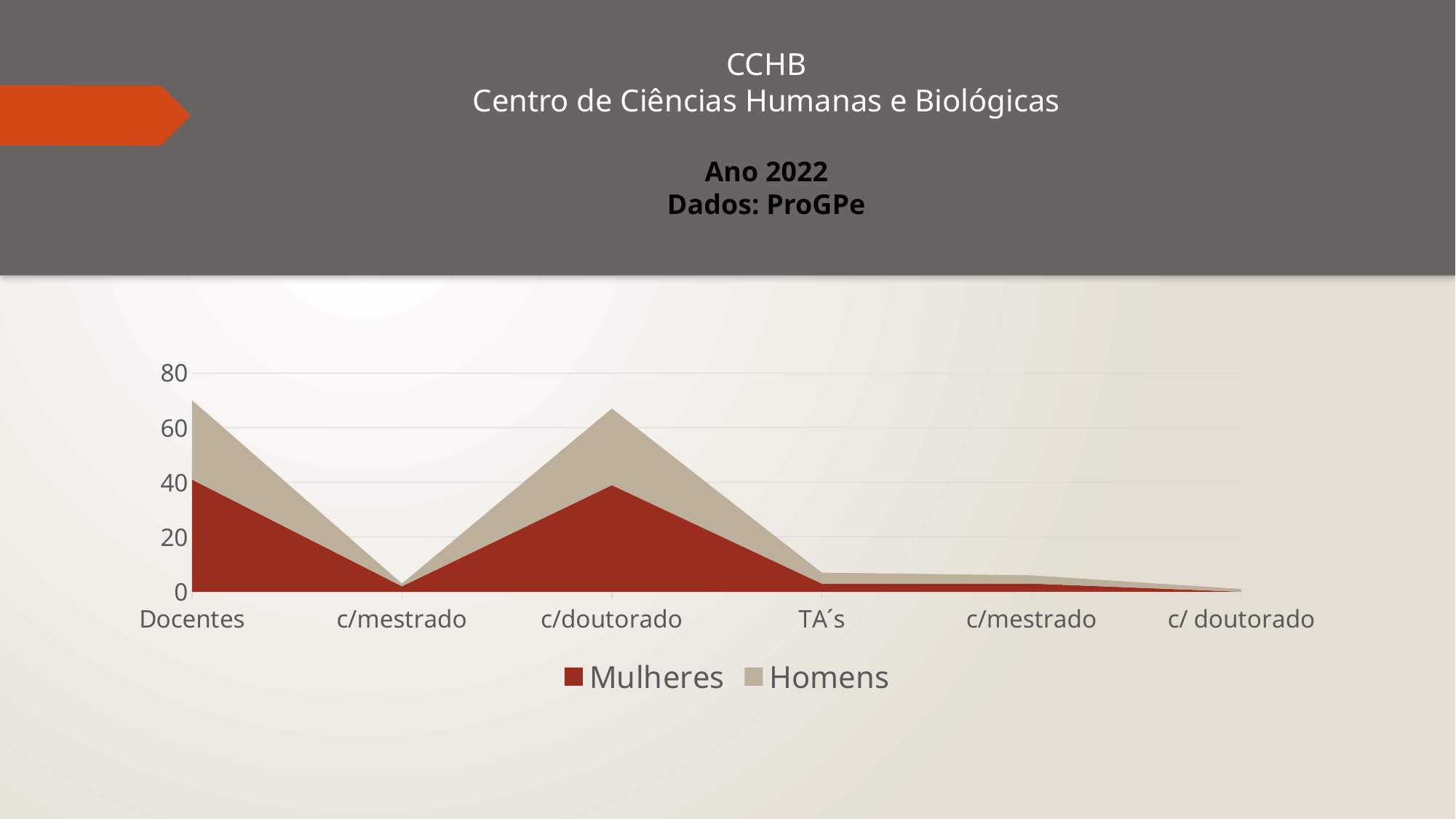
How many series does the chart legend list? 2 Is the Mulheres value for Docentes greater or less than 60? less Is the Mulheres value for c/doutorado (third category) greater or less than 20? greater Is the Mulheres value for Docentes greater or less than 20? greater Which is larger: the Mulheres value for Docentes or the Mulheres value for TA´s? Docentes What kind of chart is shown on the slide? Area chart How many categories are shown along the x axis of the chart? 6 Do the values rise or fall along the x axis from c/doutorado (third category) to c/ doutorado (last category)? Fall Which colour represents the Mulheres series in the chart? Dark red Which series are listed in the chart legend? Mulheres and Homens